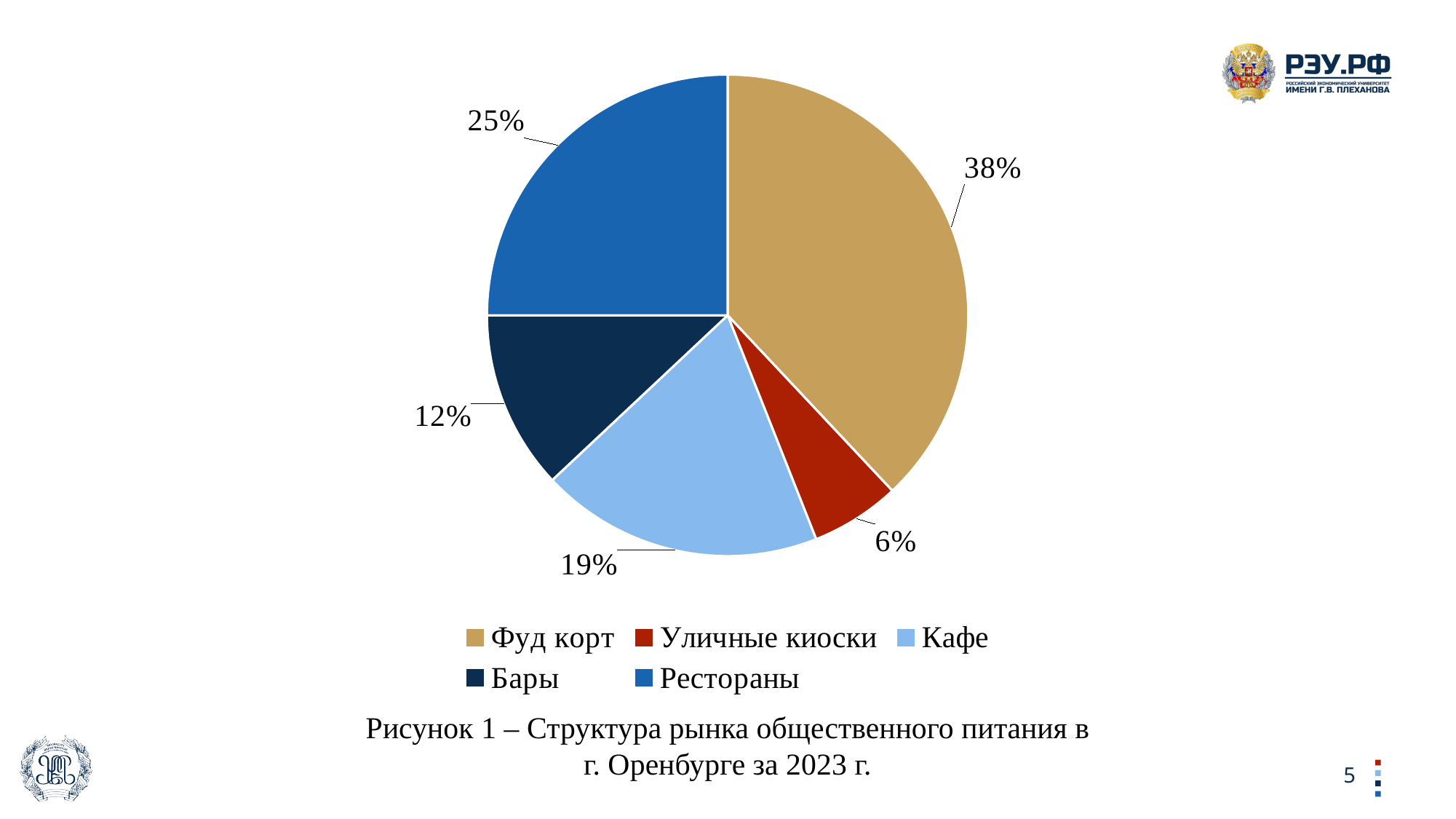
What is the caption of the chart? Рисунок 1 – Структура рынка общественного питания в г. Оренбурге за 2023 г. What share of the market does Фуд корт hold? 38% Which is larger, the share for Кафе or the share for Бары? Кафе Which category has the largest slice of the pie? Фуд корт What share of the market does Уличные киоски hold? 6% What is the difference in percentage points between Фуд корт and Рестораны? 13 How many categories does the pie chart show? 5 Which category has the smallest slice of the pie? Уличные киоски What share of the market does Рестораны hold? 25% What share of the market does Кафе hold? 19% What kind of chart is shown on the slide? Pie chart What share of the market does Бары hold? 12%